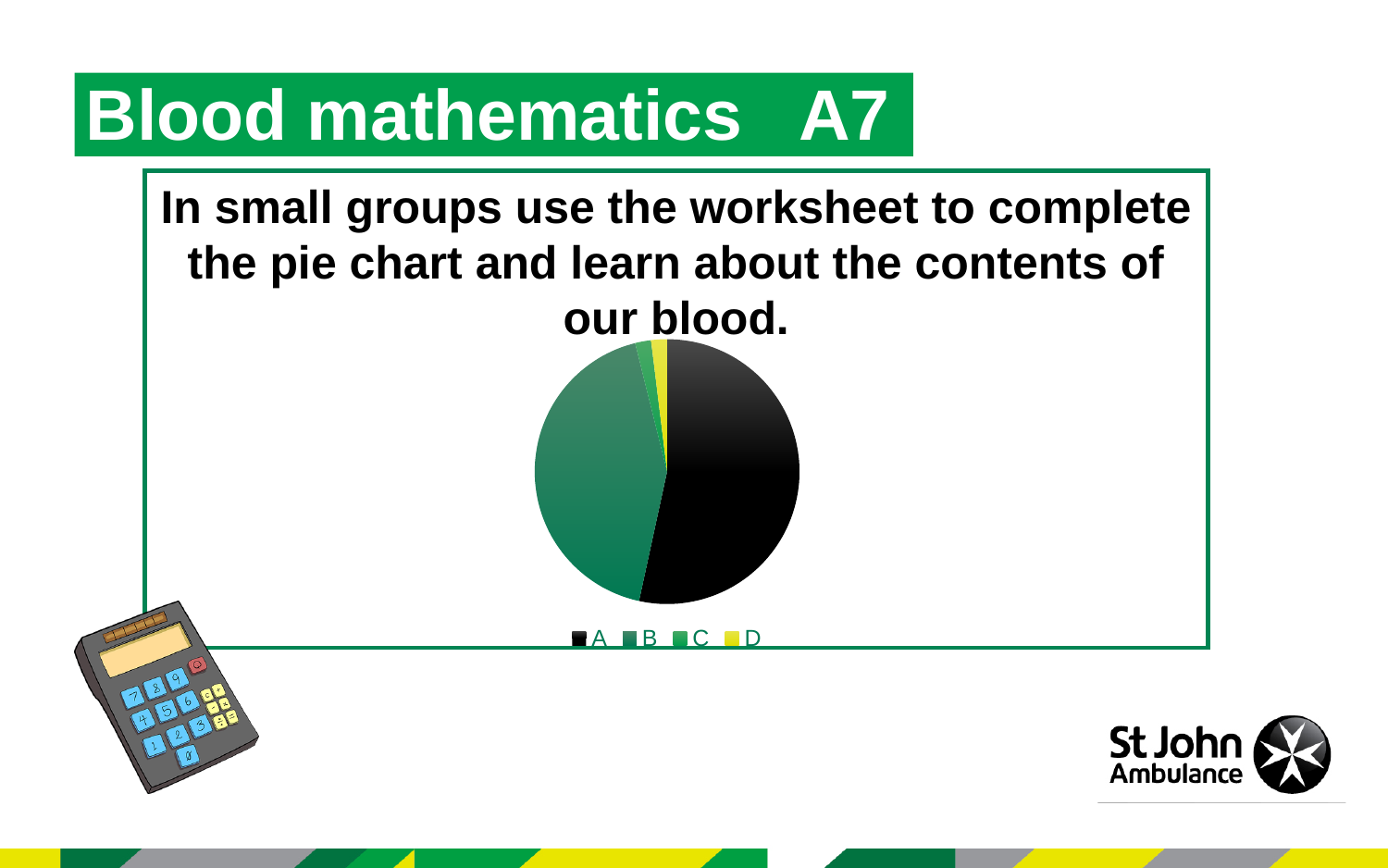
Which slice is larger in the pie chart, A or B? A Which slice is larger in the pie chart, A or C? A Which category has the largest slice of the pie chart? A What kind of chart is shown on the slide? pie chart What are the legend entries of the pie chart? A, B, C, D How many categories does the pie chart's legend list? 4 What colour is slice A in the pie chart? black Which slice is larger in the pie chart, B or D? B